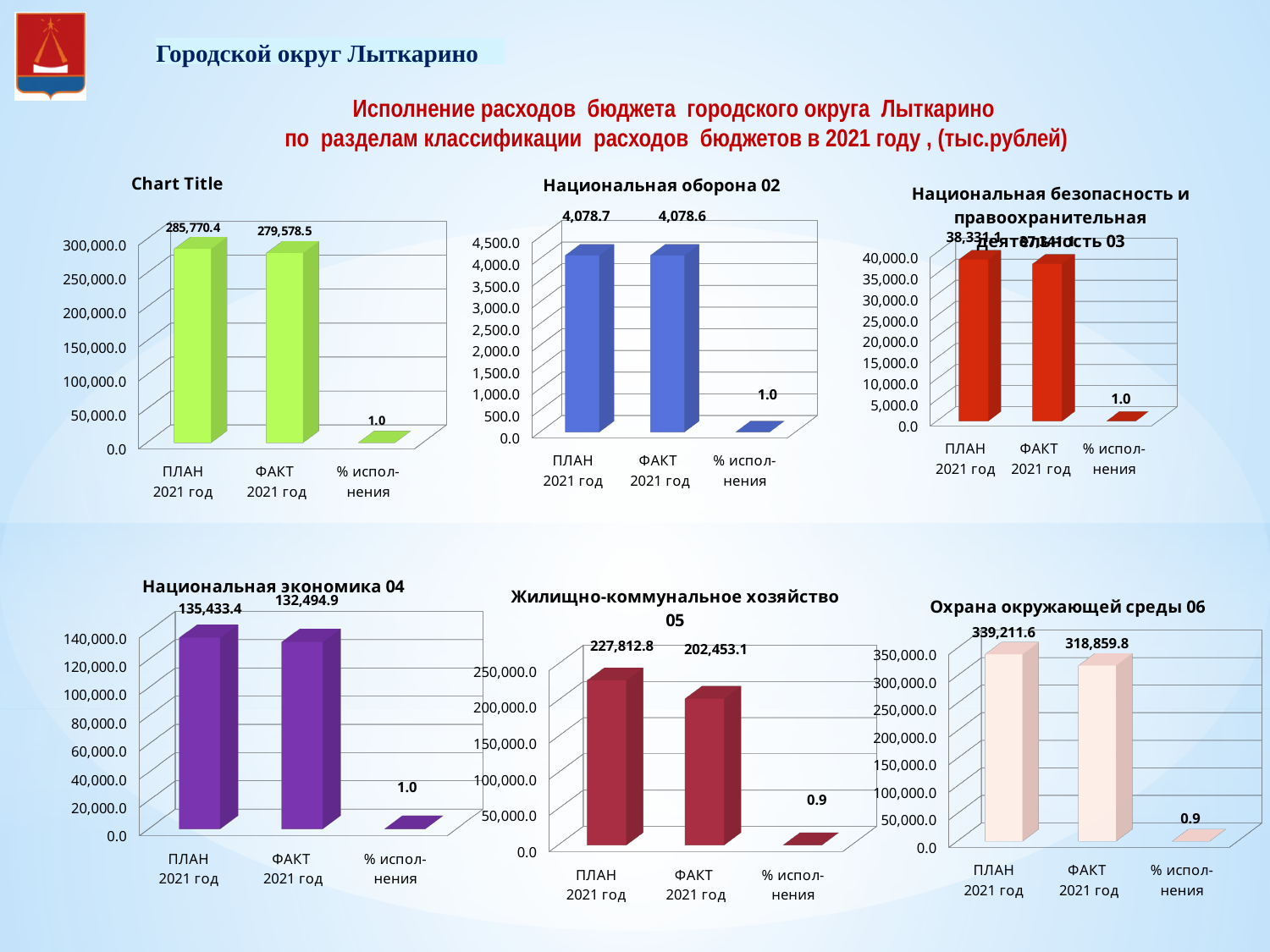
On the top-left chart titled "Chart Title", what is the value for ФАКТ 2021 год? 279,578.5 On the chart titled "Национальная экономика 04", which is larger, ПЛАН 2021 год or ФАКТ 2021 год? ПЛАН 2021 год On the chart titled "Жилищно-коммунальное хозяйство 05", what is the difference between ПЛАН 2021 год and ФАКТ 2021 год? 25,359.7 What kind of chart is the one titled "Национальная оборона 02"? bar chart On the chart titled "Национальная экономика 04", what is the value for % исполнения? 1.0 On the chart titled "Охрана окружающей среды 06", what is the difference between ПЛАН 2021 год and ФАКТ 2021 год? 20,351.8 On the chart titled "Национальная безопасность и правоохранительная деятельность 03", is the value for ФАКТ 2021 год greater or less than 35,000.0? greater On the chart titled "Жилищно-коммунальное хозяйство 05", which category has the lowest value? % исполнения On the chart titled "Национальная оборона 02", what is the value for ПЛАН 2021 год? 4,078.7 How many categories are shown on the chart titled "Охрана окружающей среды 06"? 3 On the chart titled "Охрана окружающей среды 06", what is the value for ПЛАН 2021 год? 339,211.6 On the chart titled "Жилищно-коммунальное хозяйство 05", what is the value for ФАКТ 2021 год? 202,453.1